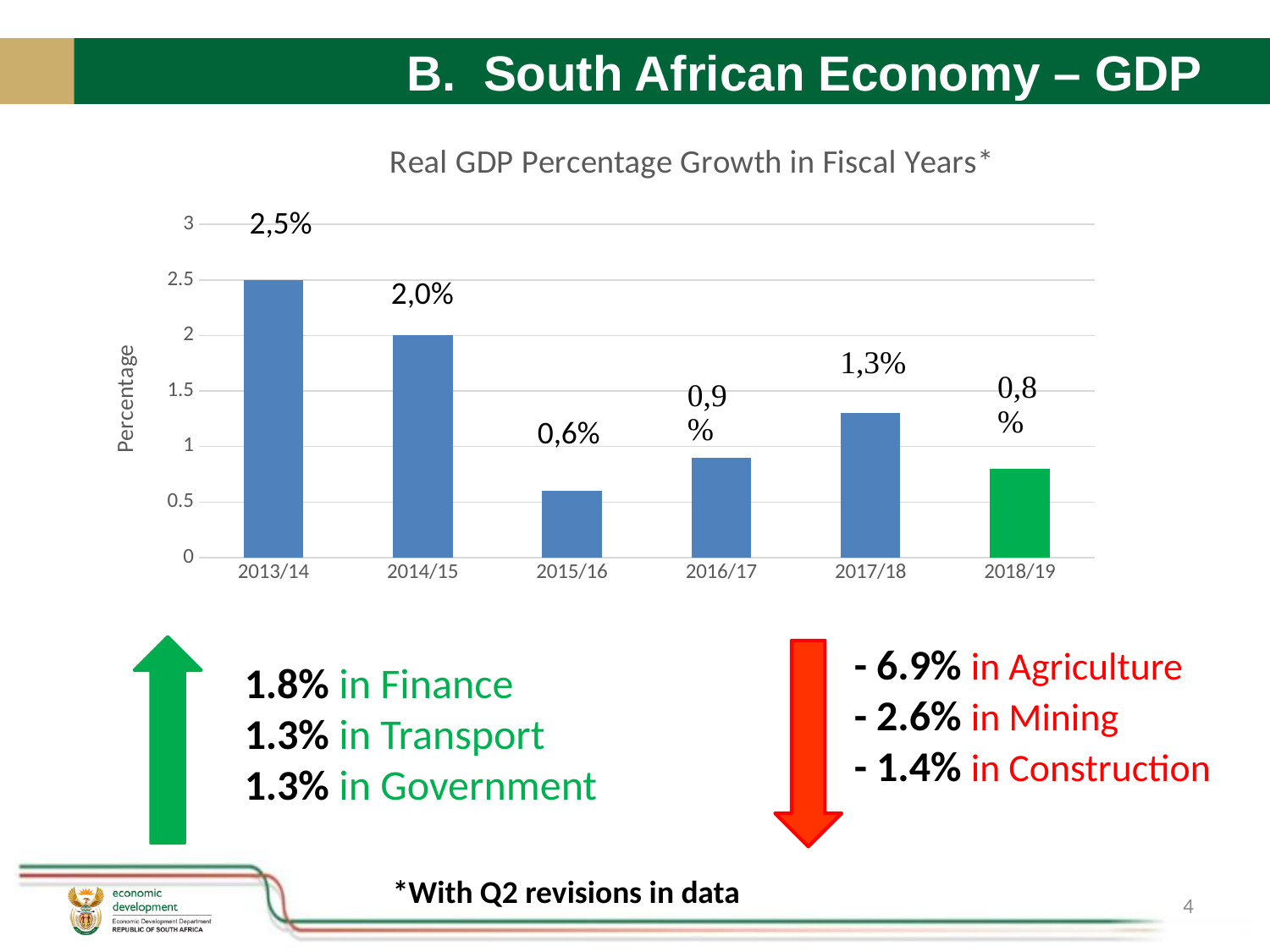
What is the difference in Real GDP percentage growth between 2013/14 and 2014/15? 0,5% Which fiscal year has the highest Real GDP percentage growth? 2013/14 What is the Real GDP percentage growth for 2015/16? 0,6% What is the Real GDP percentage growth for 2018/19? 0,8% What is the difference in Real GDP percentage growth between 2017/18 and 2018/19? 0,5% Which fiscal year has higher Real GDP percentage growth, 2016/17 or 2017/18? 2017/18 Is the value for 2014/15 greater or less than 1.5? greater What is the label of the vertical axis of the chart? Percentage How many fiscal years are shown on the chart? 6 What kind of chart is used to show Real GDP Percentage Growth in Fiscal Years? Bar chart Which fiscal year has the lowest Real GDP percentage growth? 2015/16 What is the Real GDP percentage growth for 2013/14? 2,5%